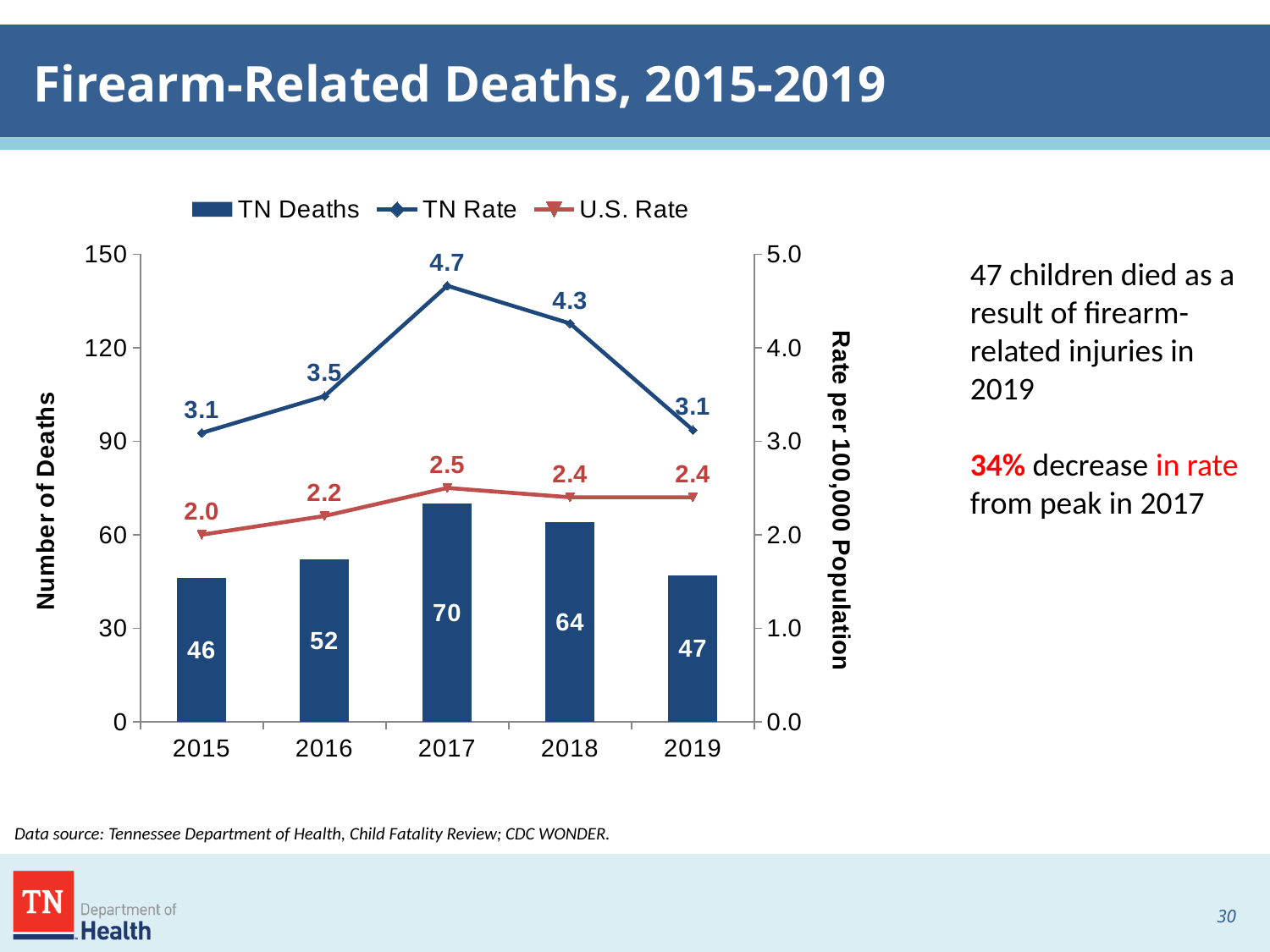
How did the TN Rate change from 2017 to 2019? It fell What is the label of the right-hand vertical axis? Rate per 100,000 Population Which year had the lowest U.S. Rate? 2015 How many series does the legend list? 3 Is the number of TN Deaths in 2016 greater or less than 60? less How many years are shown on the x axis? 5 Which year had the highest number of TN Deaths? 2017 What was the TN Rate in 2019? 3.1 Which is larger, the TN Rate in 2016 or the TN Rate in 2018? TN Rate in 2018 What was the U.S. Rate in 2016? 2.2 What is the difference in TN Deaths between 2018 and 2019? 17 How many TN Deaths were there in 2017? 70